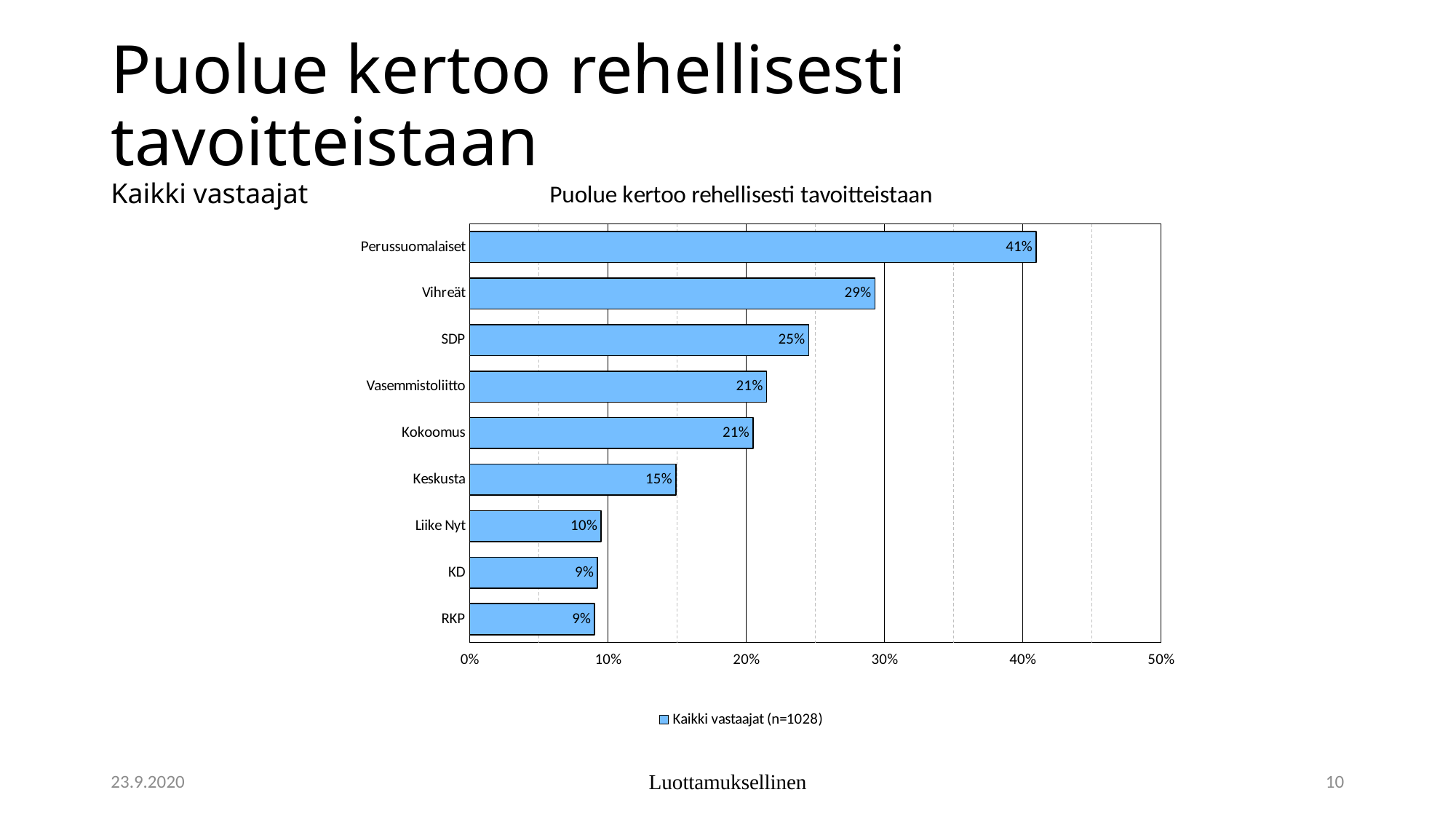
Is the value for Vasemmistoliitto greater or less than 30%? less What is the difference between the values for Perussuomalaiset and Vihreät? 12% What is the value for Keskusta? 15% How many parties are shown in the chart? 9 What kind of chart is shown on the slide? Bar chart What is the difference between the values for SDP and Keskusta? 10% What is the value for Vihreät? 29% What is the legend entry of the chart? Kaikki vastaajat (n=1028) What is the value for Liike Nyt? 10% Which party has the highest value? Perussuomalaiset Which has a larger value, SDP or Kokoomus? SDP What is the value for Perussuomalaiset? 41%